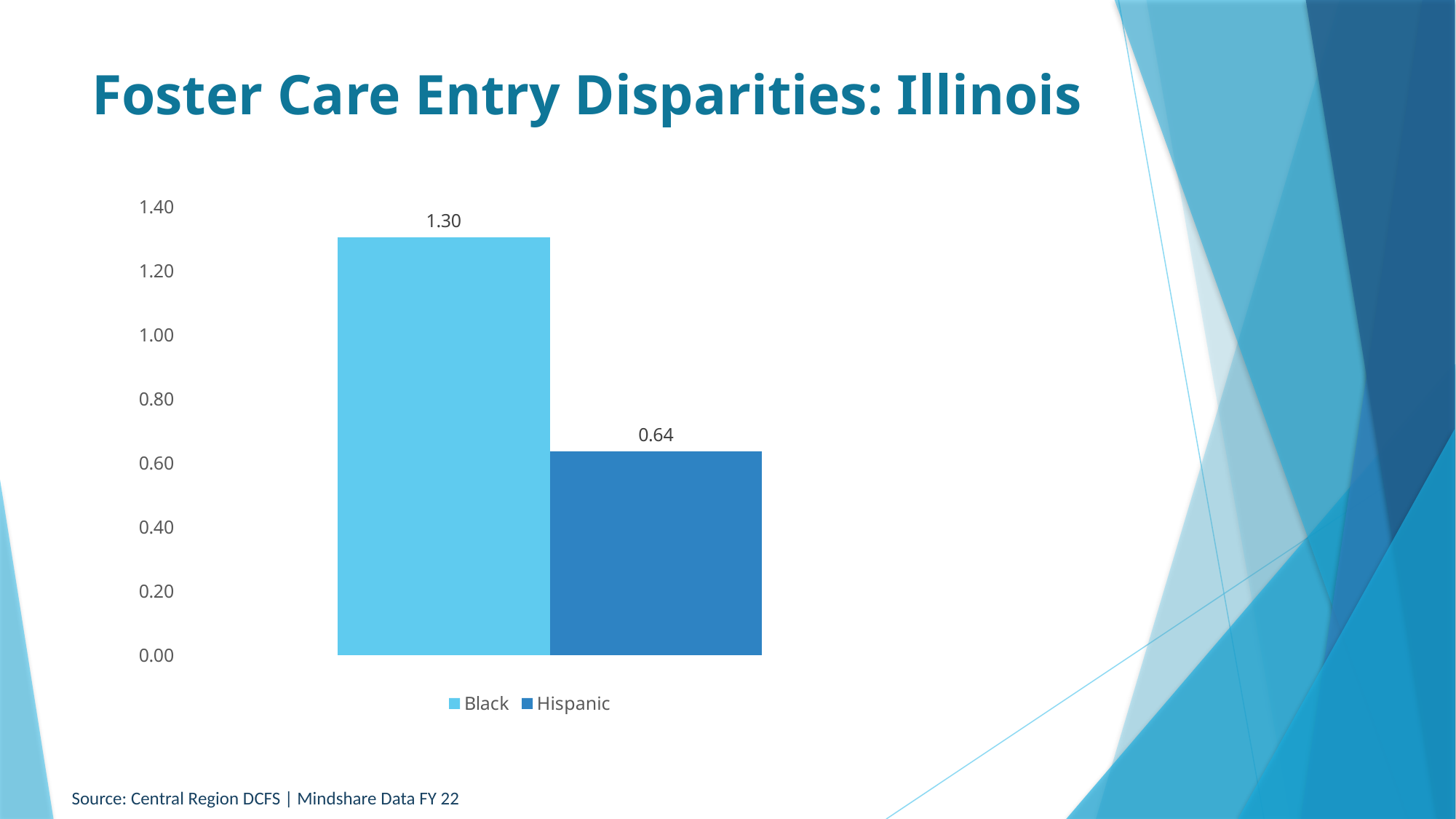
What is the maximum value shown on the vertical axis? 1.40 Which series has the highest value? Black Which series has the lowest value? Hispanic What is the value for Hispanic? 0.64 How many series does the legend list? 2 What is the value for Black? 1.30 Is the value for Black greater or less than 1.20? greater What kind of chart is shown on the slide? bar chart Which is larger, the value for Black or the value for Hispanic? Black Is the value for Hispanic greater or less than 0.80? less What is the title of the slide? Foster Care Entry Disparities: Illinois What is the difference between the values for Black and Hispanic? 0.66